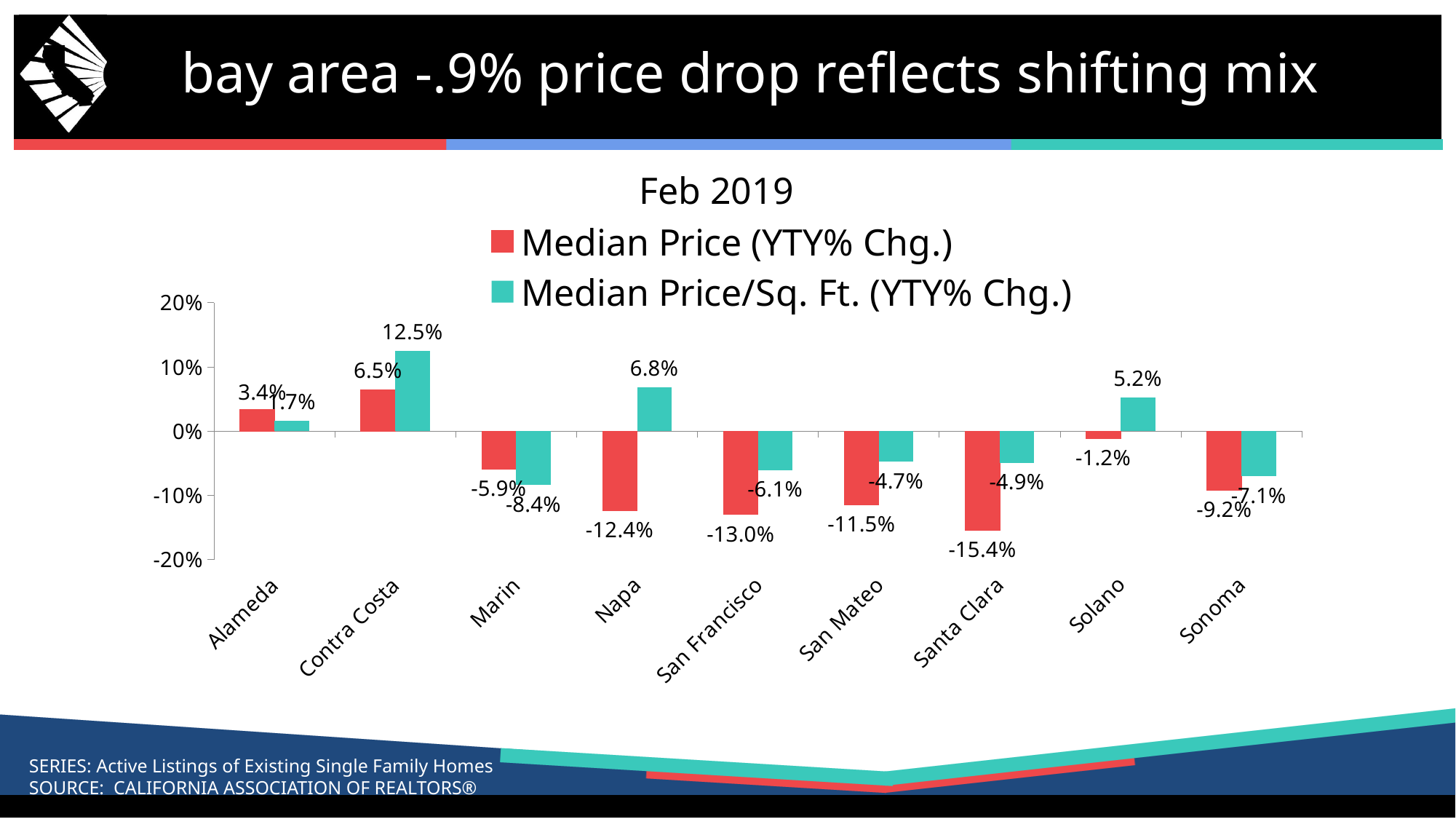
Is the Median Price (YTY% Chg.) value for San Francisco greater or less than -10%? less What is the title shown above the chart legend? Feb 2019 Which county has the lowest Median Price (YTY% Chg.) value? Santa Clara How many counties are shown on the x axis? 9 Which is larger for Sonoma: the Median Price (YTY% Chg.) value or the Median Price/Sq. Ft. (YTY% Chg.) value? Median Price/Sq. Ft. (YTY% Chg.) How many series does the legend list? 2 What kind of chart is shown on the slide? Bar chart What is the Median Price (YTY% Chg.) value for Santa Clara? -15.4% What is the difference between the Median Price/Sq. Ft. (YTY% Chg.) and Median Price (YTY% Chg.) values for Napa? 19.2 percentage points Which county has the highest Median Price/Sq. Ft. (YTY% Chg.) value? Contra Costa What is the Median Price/Sq. Ft. (YTY% Chg.) value for Napa? 6.8% What is the Median Price/Sq. Ft. (YTY% Chg.) value for Contra Costa? 12.5%